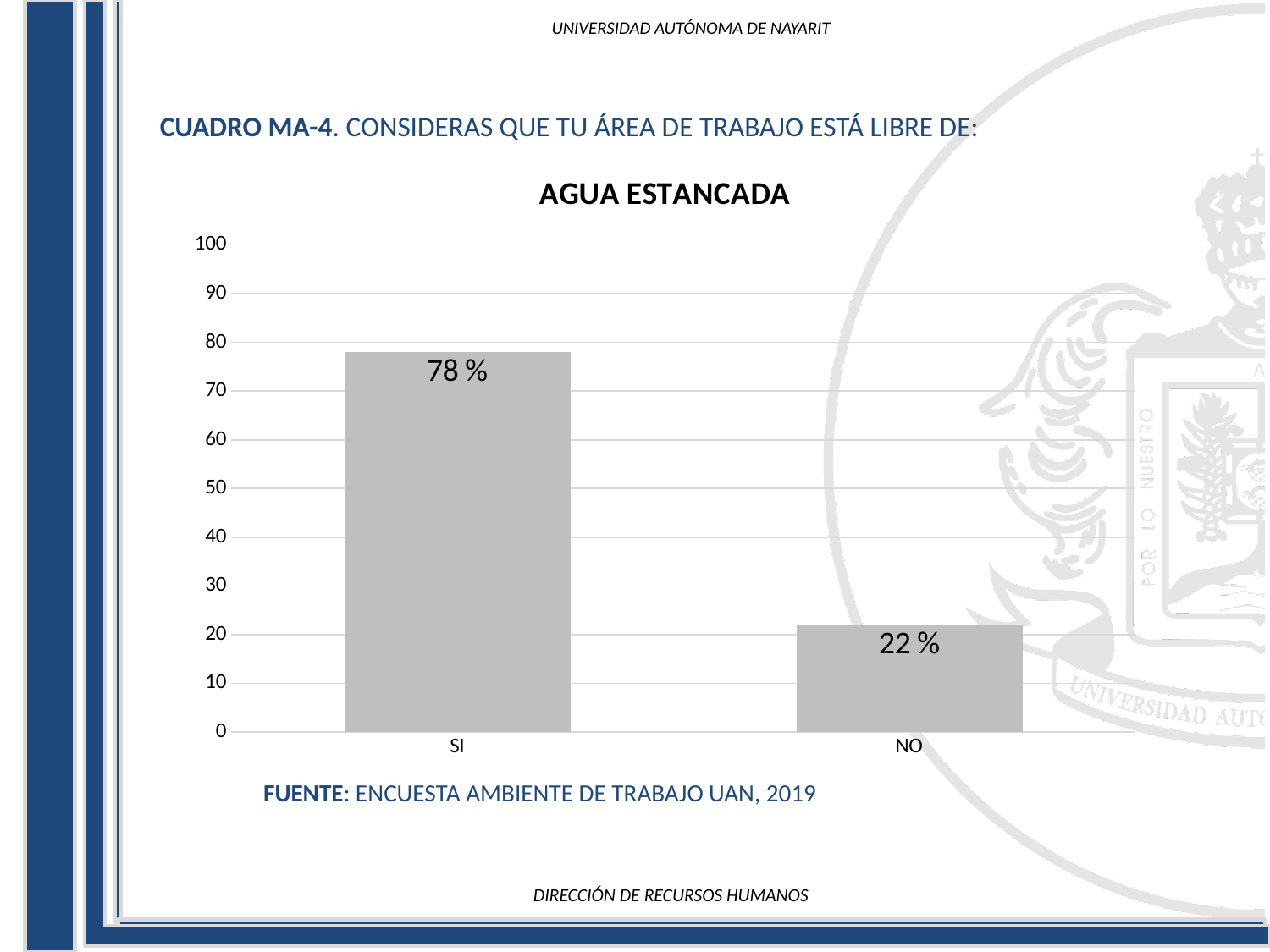
Which is larger, the value for SI or the value for NO? SI How many categories are shown on the x axis? 2 Is the value for SI greater or less than 70? greater What is the value for SI? 78 % What is the difference between the values for SI and NO? 56 % Is the value for NO greater or less than 30? less What is the highest value shown on the y axis? 100 Which category has the lowest value? NO What kind of chart is shown? bar chart What is the value for NO? 22 % What is the title of the chart? AGUA ESTANCADA Which category has the highest value? SI